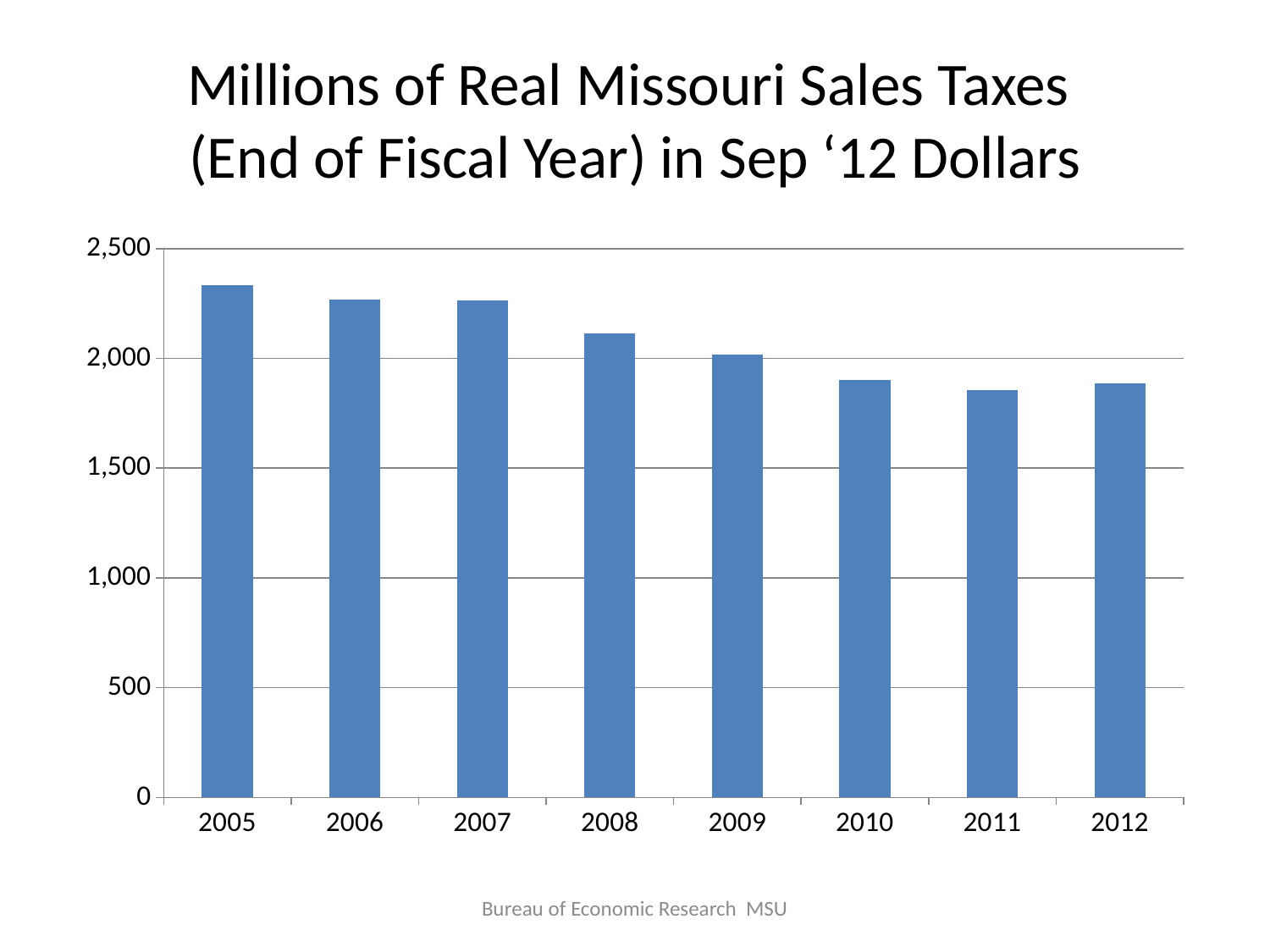
Which year has the highest value of real Missouri sales taxes? 2005 Is the value for 2010 greater or less than 2,000? less Is the value for 2006 greater or less than 2,500? less Which is larger, the value for 2009 or the value for 2011? 2009 What kind of chart is shown on the slide? bar chart Is the value for 2005 greater or less than 2,000? greater Which is larger, the value for 2005 or the value for 2008? 2005 What is the title of the chart? Millions of Real Missouri Sales Taxes (End of Fiscal Year) in Sep '12 Dollars How many years are plotted on the chart? 8 Do the values generally rise or fall from 2005 to 2012? fall